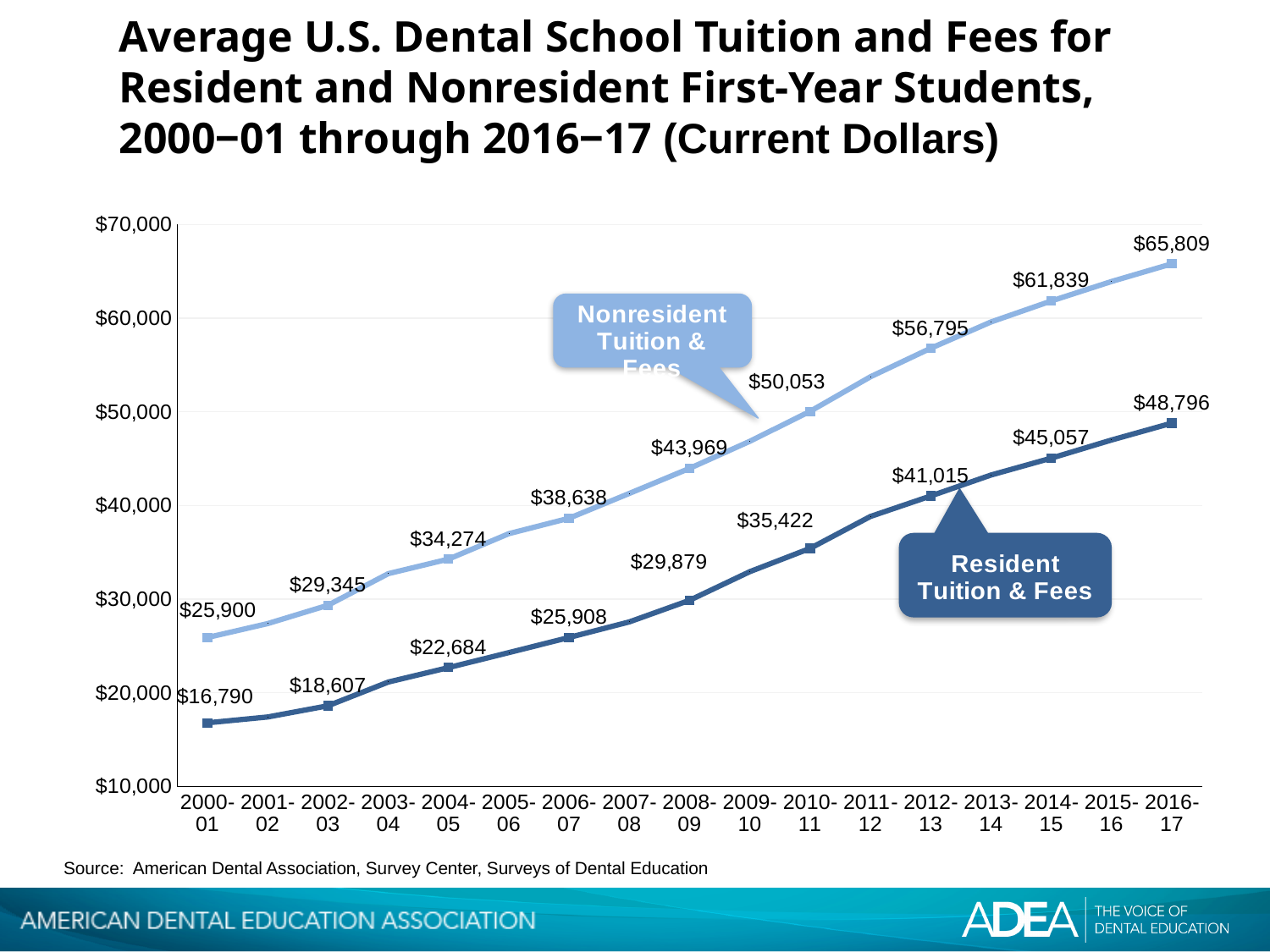
What was the average nonresident tuition and fees for first-year students in 2016-17? $65,809 What is the difference between nonresident and resident tuition and fees in 2016-17? $17,013 How many academic years are shown on the x axis? 17 In which academic year was nonresident tuition and fees highest? 2016-17 What was the average resident tuition and fees for first-year students in 2000-01? $16,790 Do resident tuition and fees rise or fall from 2000-01 to 2016-17? Rise In which academic year was resident tuition and fees lowest? 2000-01 Is the resident tuition and fees value for 2011-12 greater or less than $30,000? greater What type of chart is shown on the slide? Line chart What was the average resident tuition and fees in 2010-11? $35,422 Which was larger in 2012-13: nonresident tuition and fees or resident tuition and fees? Nonresident tuition and fees What was the average nonresident tuition and fees in 2006-07? $38,638